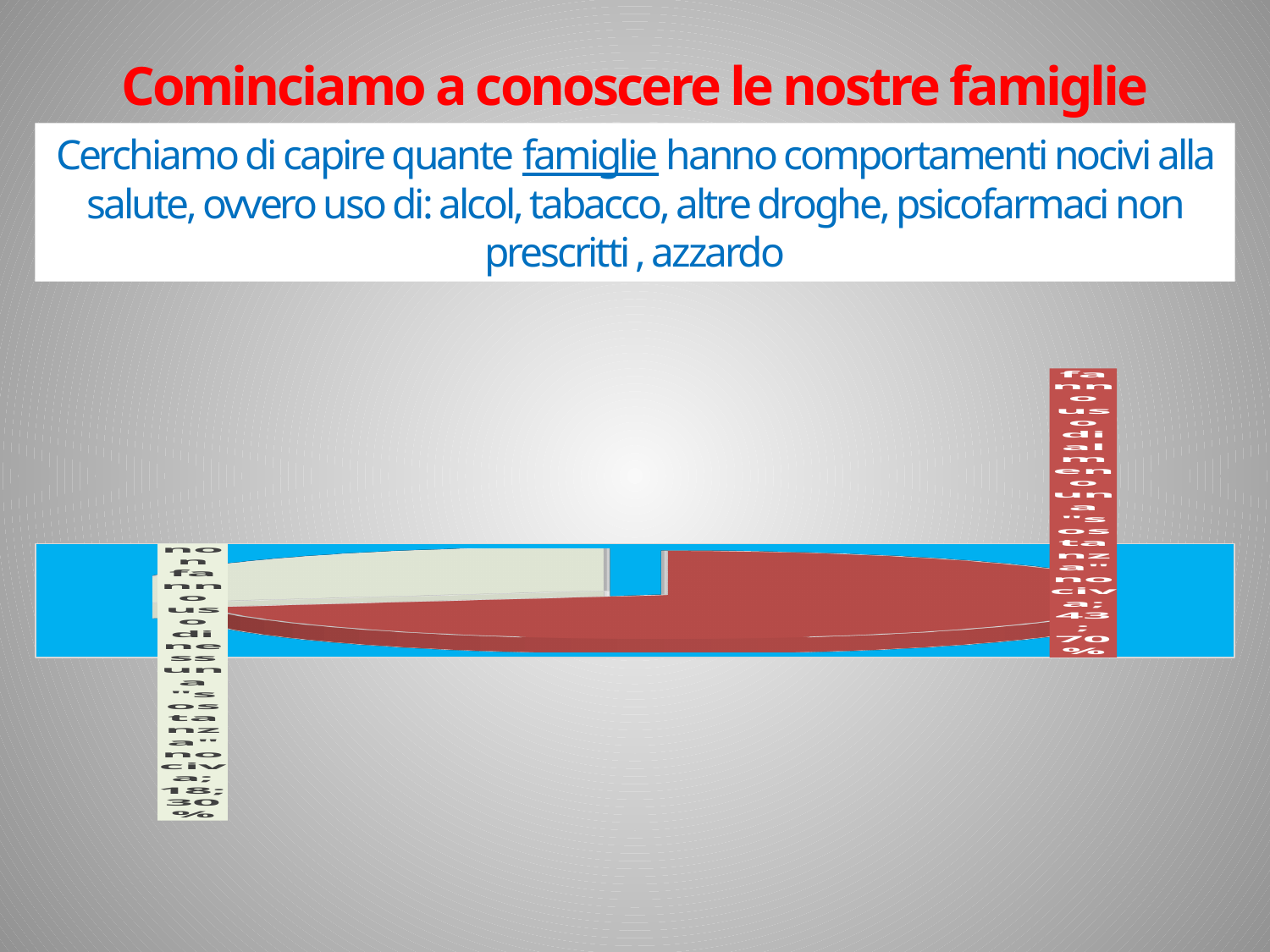
How many slices does the pie chart have? 2 What kind of chart is shown on the slide? pie chart What colour is the slice for families that use at least one harmful substance? red What percentage of families is labelled as "fanno uso di almeno una sostanza nociva"? 70% How many families are in the "fanno uso di almeno una sostanza nociva" slice? 43 Which group has more families: those who use at least one harmful substance or those who use none? fanno uso di almeno una sostanza nociva What percentage of families is labelled as "non fanno uso di nessuna sostanza nociva"? 30% What is the difference in the number of families between the "fanno uso" slice (43) and the "non fanno uso" slice (18)? 25 Which slice of the pie chart is the largest? fanno uso di almeno una sostanza nociva What is the total number of families represented in the pie chart? 61 Which slice of the pie chart is the smallest? non fanno uso di nessuna sostanza nociva How many families are in the "non fanno uso di nessuna sostanza nociva" slice? 18